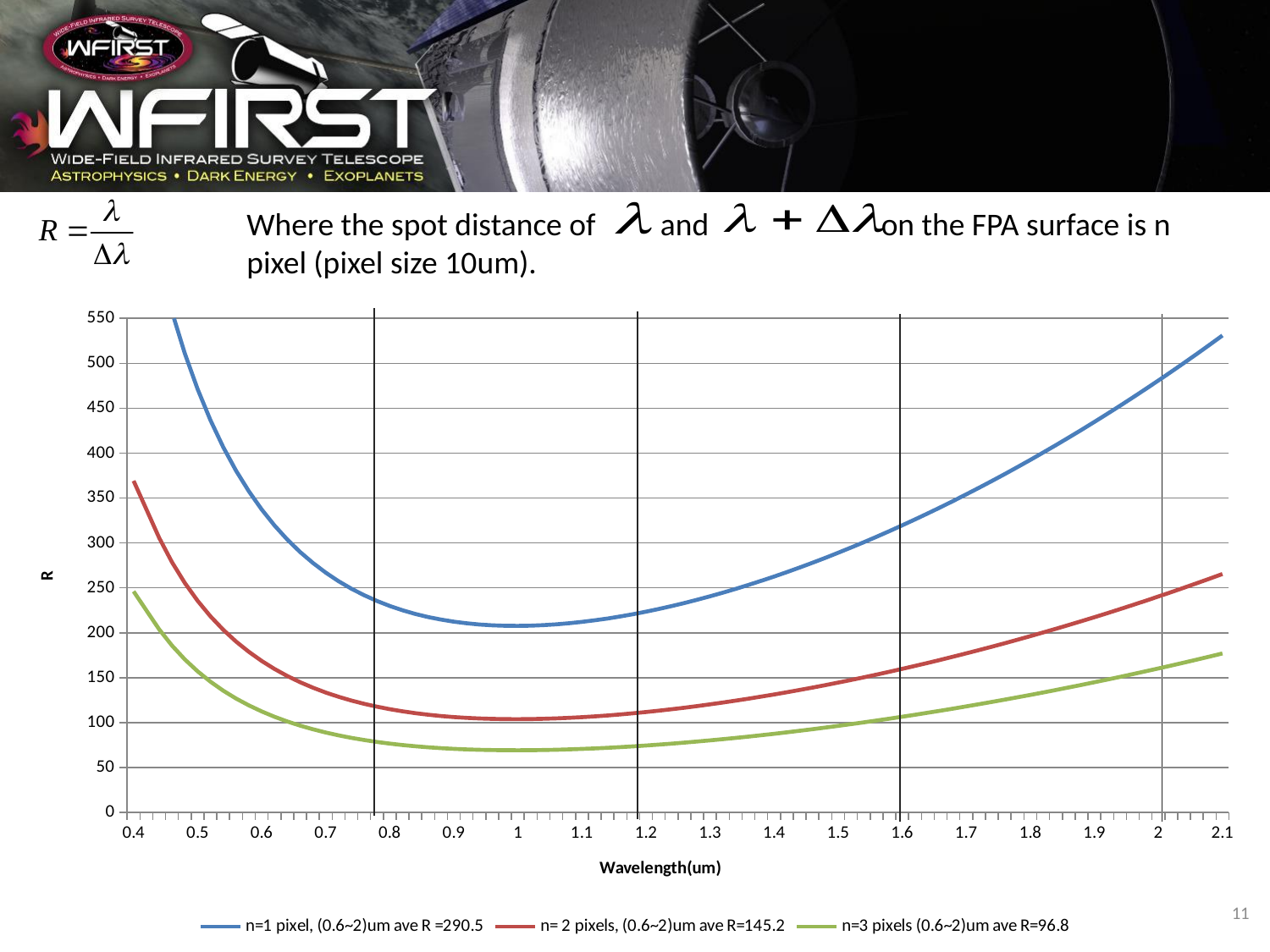
What is the label of the x axis? Wavelength(um) Which series has the lowest R at 1 um? n=3 pixels Is the value of the n=2 pixels curve at 0.4 um greater or less than 300? greater Does the n=1 pixel curve rise or fall between 1 um and 2.1 um? rise According to the legend, what is the (0.6~2)um average R for n=2 pixels? 145.2 What is the difference between the legend's average R for n=1 pixel and for n=2 pixels? 145.3 Is the value of the n=1 pixel curve at 1 um greater or less than 250? less How many series does the legend list? 3 According to the legend, what is the (0.6~2)um average R for n=1 pixel? 290.5 What kind of chart is shown on the slide? line chart Which series has the highest average R in the legend? n=1 pixel According to the legend, what is the (0.6~2)um average R for n=3 pixels? 96.8